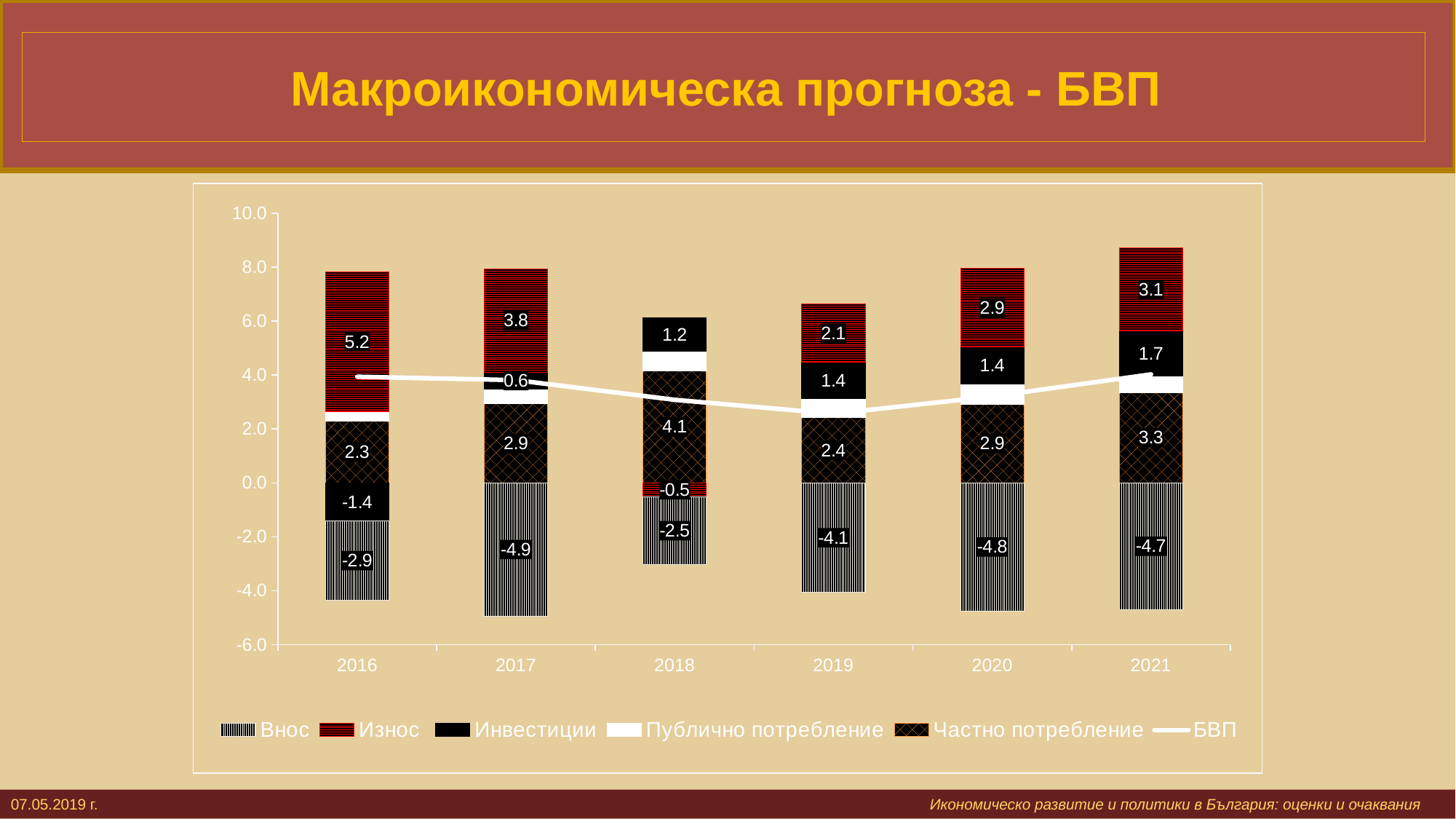
In which year is the Износ value the highest? 2016 Is the БВП line value for 2019 greater or less than 4.0? less What is the difference between Частно потребление in 2021 and in 2019? 0.9 What is the value of Внос for 2017? -4.9 Which year has the larger Износ value, 2020 or 2021? 2021 In which year is the Внос value the most negative? 2017 How many series does the legend list? 6 How many years are shown on the x axis? 6 What is the value of Частно потребление for 2018? 4.1 What is the title of the slide? Макроикономическа прогноза - БВП What is the value of Инвестиции for 2021? 1.7 What is the value of Износ for 2016? 5.2